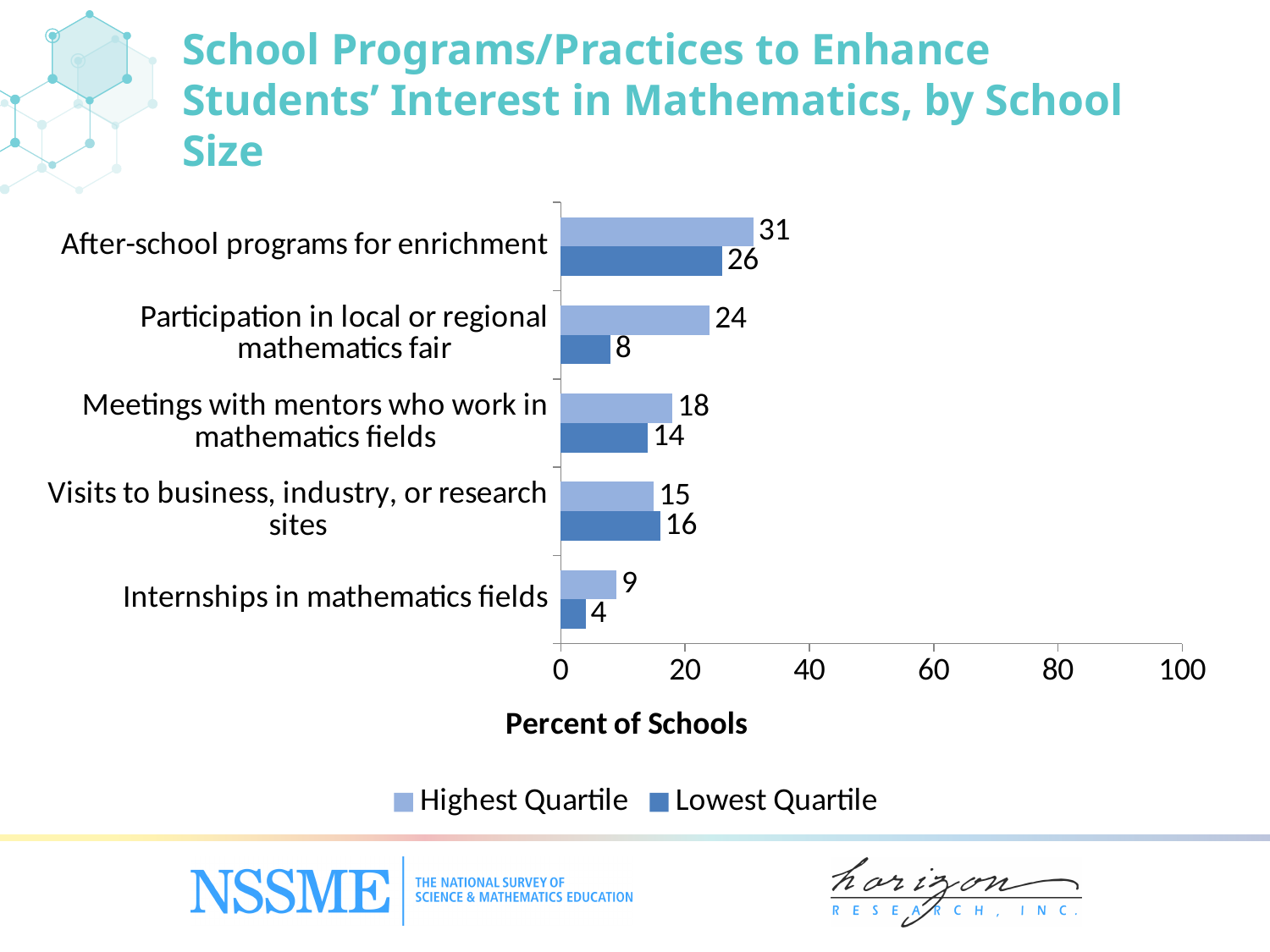
What is the Lowest Quartile value for Internships in mathematics fields? 4 Which category has the highest Highest Quartile value? After-school programs for enrichment Which category has the lowest Lowest Quartile value? Internships in mathematics fields How many categories are shown on the chart? 5 For Visits to business, industry, or research sites, which is larger: the Highest Quartile value or the Lowest Quartile value? Lowest Quartile How many series does the legend list? 2 What kind of chart is shown on the slide? Bar chart What is the Highest Quartile value for After-school programs for enrichment? 31 What is the Lowest Quartile value for Participation in local or regional mathematics fair? 8 Is the Highest Quartile value for After-school programs for enrichment greater or less than 20? greater What is the label of the horizontal axis? Percent of Schools What is the difference between the Highest Quartile and Lowest Quartile values for Participation in local or regional mathematics fair? 16